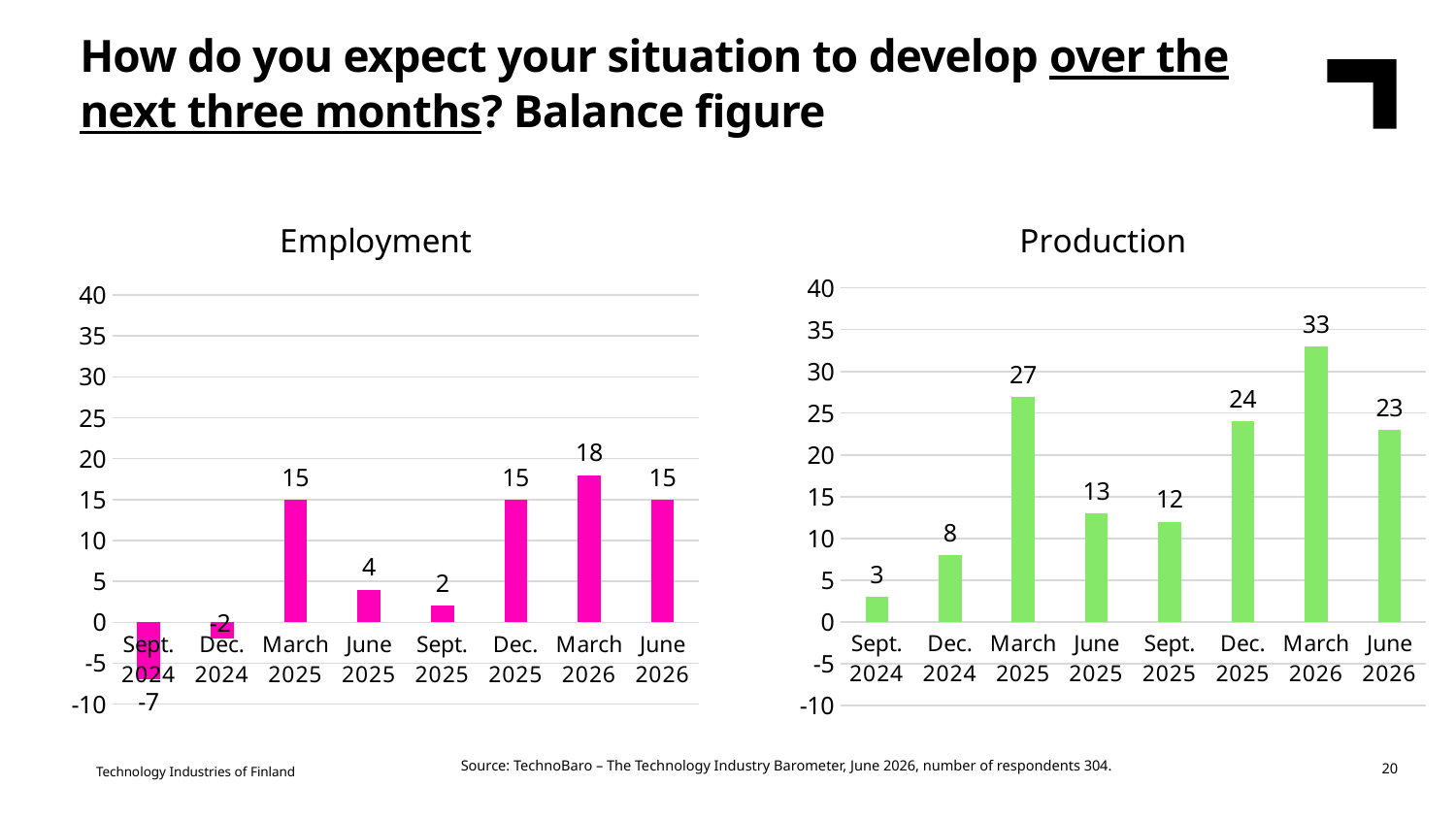
In the Employment chart, what is the value for Sept. 2024? -7 How many periods are shown on the x axis of the Employment chart? 8 In the Employment chart, what is the value for March 2026? 18 In the Employment chart, which period has the lowest value? Sept. 2024 In the Employment chart, what is the difference between the values for March 2025 and June 2025? 11 In the Production chart, what is the value for Dec. 2025? 24 In the Production chart, what is the difference between the values for March 2026 and June 2026? 10 What colour are the bars in the Employment chart? Pink In the Production chart, which is larger: the value for June 2025 or the value for Sept. 2025? June 2025 What type of chart is the Production chart? Bar chart In the Production chart, which period has the lowest value? Sept. 2024 In the Production chart, which period has the highest value? March 2026